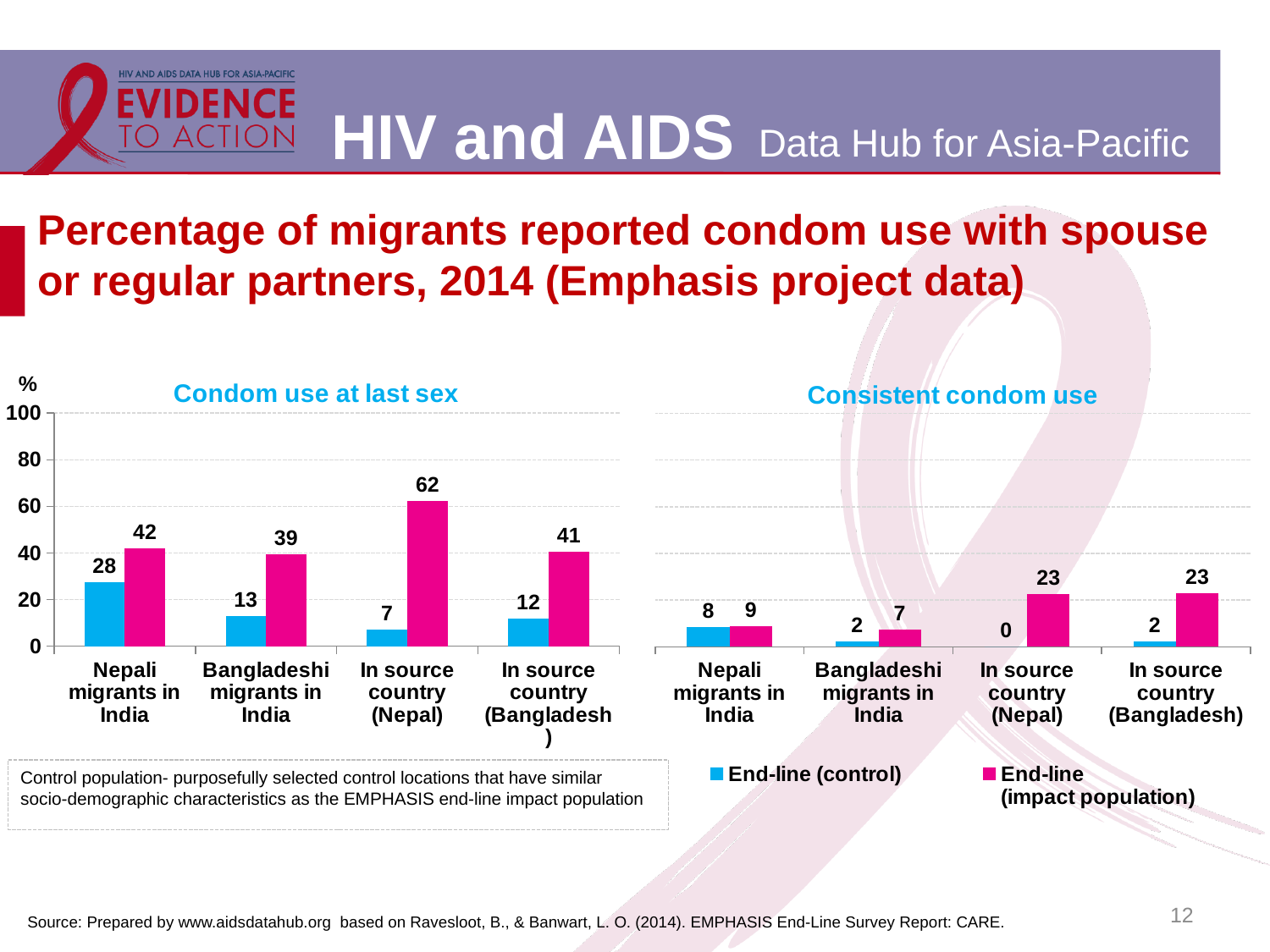
What kind of chart is the 'Consistent condom use' chart? Bar chart In the 'Consistent condom use' chart, what is the difference between the End-line (impact population) and End-line (control) values for In source country (Bangladesh)? 21 In the 'Consistent condom use' chart, what is the End-line (impact population) value for Bangladeshi migrants in India? 7 In the 'Consistent condom use' chart, what is the End-line (control) value for In source country (Nepal)? 0 In the 'Condom use at last sex' chart, which category has the lowest End-line (control) value? In source country (Nepal) In the 'Consistent condom use' chart, which is larger for Nepali migrants in India: the End-line (control) value or the End-line (impact population) value? End-line (impact population) How many series does the legend list? 2 In the 'Condom use at last sex' chart, which category has the highest End-line (impact population) value? In source country (Nepal) In the 'Condom use at last sex' chart, what is the End-line (impact population) value for In source country (Nepal)? 62 How many categories are shown on the x axis of the 'Condom use at last sex' chart? 4 In the 'Condom use at last sex' chart, what is the difference between the End-line (impact population) and End-line (control) values for Bangladeshi migrants in India? 26 In the 'Condom use at last sex' chart, what is the End-line (control) value for Nepali migrants in India? 28